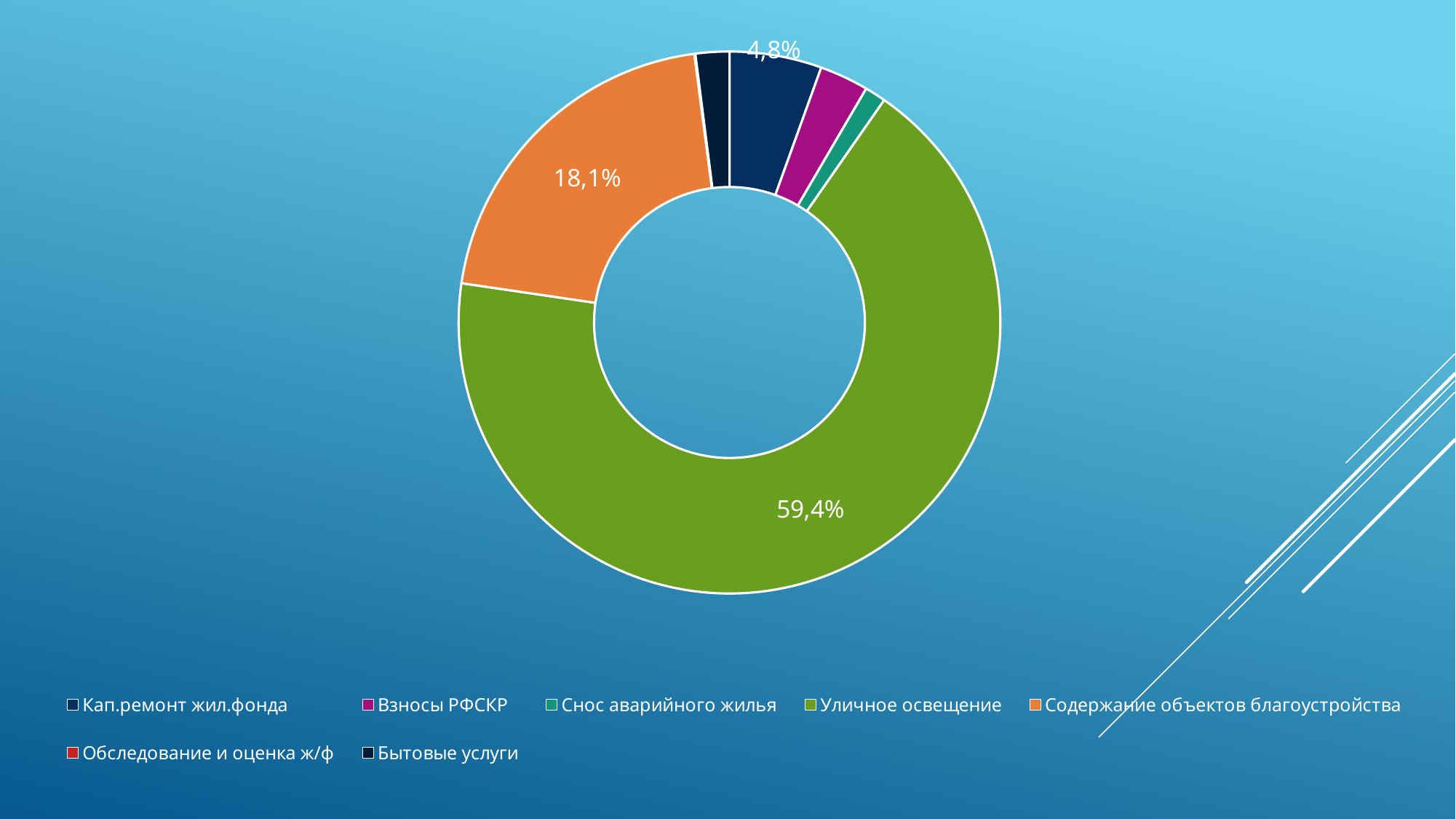
Which is larger: the share for Содержание объектов благоустройства or for Кап.ремонт жил.фонда? Содержание объектов благоустройства What colour represents Уличное освещение in the chart? Green What percentage is shown for Уличное освещение? 59,4% What percentage is shown for Кап.ремонт жил.фонда? 4,8% Which is larger: the share for Кап.ремонт жил.фонда or for Бытовые услуги? Кап.ремонт жил.фонда What is the difference in percentage points between Уличное освещение and Содержание объектов благоустройства? 41,3 What percentage is shown for Содержание объектов благоустройства? 18,1% Which category has the largest share of the chart? Уличное освещение Is the share for Уличное освещение greater or less than 50%? greater What kind of chart is shown on the slide? Doughnut (pie) chart Which is larger: the share for Взносы РФСКР or for Снос аварийного жилья? Взносы РФСКР How many categories does the legend list? 7